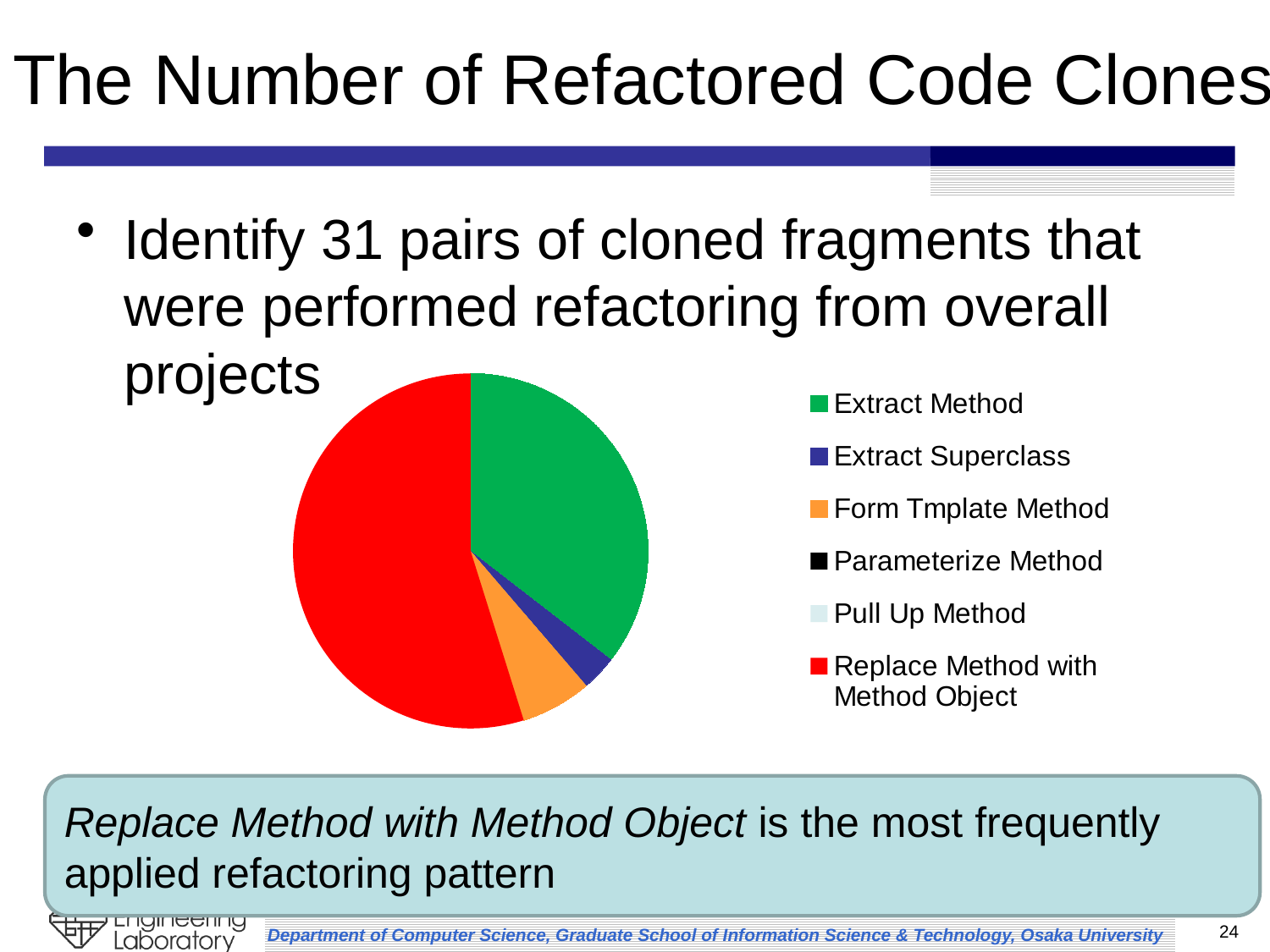
Which refactoring pattern has the largest slice of the pie chart? Replace Method with Method Object Which slice is larger in the pie chart: Extract Method or Form Tmplate Method? Extract Method What kind of chart is shown on the slide? pie chart What colour represents Extract Method in the pie chart? green Which slice is larger in the pie chart: Replace Method with Method Object or Extract Method? Replace Method with Method Object How many refactoring patterns does the legend of the pie chart list? 6 Which slice is larger in the pie chart: Form Tmplate Method or Extract Superclass? Form Tmplate Method What colour represents Replace Method with Method Object in the pie chart? red